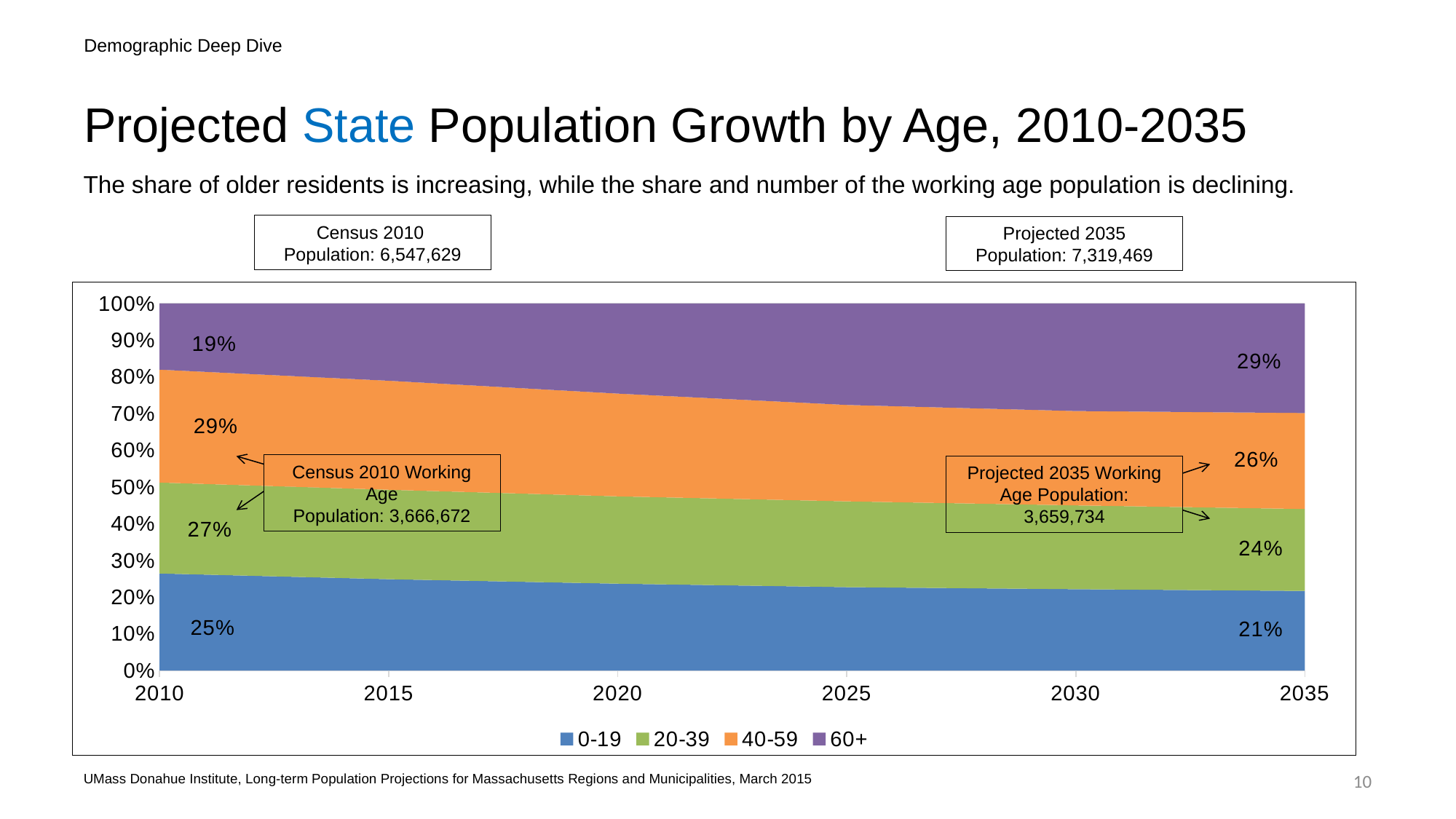
What share of the population is the 60+ age group projected to be in 2035? 29% What share of the population is the 20-39 age group projected to be in 2035? 24% Which is larger in 2035: the share of the 40-59 group or the share of the 20-39 group? 40-59 What kind of chart is shown on the slide? Stacked area chart Which age group has the largest share of the population in 2010? 40-59 Does the share of the 0-19 age group rise or fall from 2010 to 2035? Fall Which age group has the smallest share of the population in 2010? 60+ What share of the population is the 0-19 age group in 2010? 25% How many age groups does the legend list? 4 Which age group has the smallest share of the population in 2035? 0-19 What share of the population is the 60+ age group in 2010? 19% By how many percentage points does the 60+ share change from 2010 to 2035? 10 percentage points